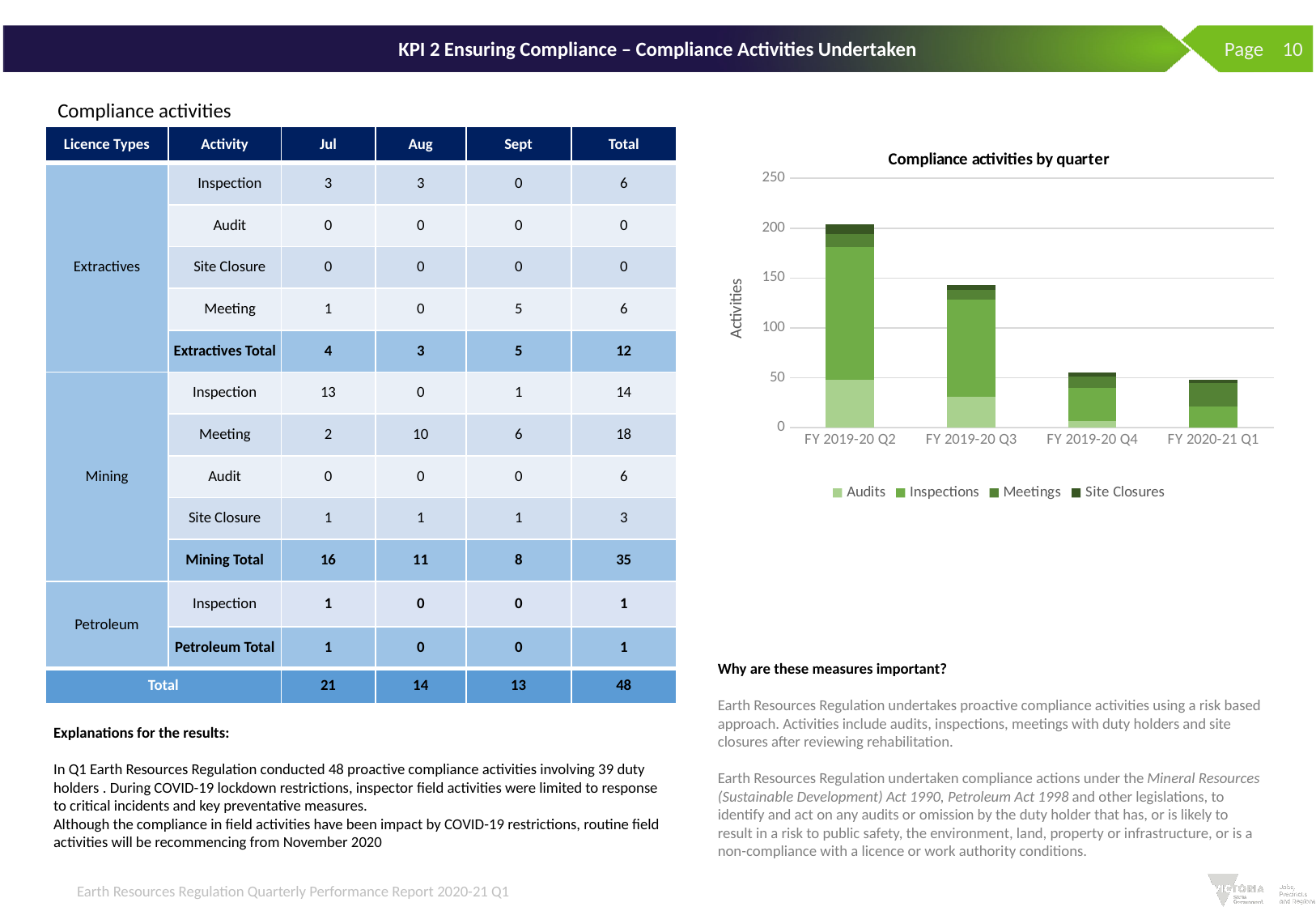
Is the total for FY 2019-20 Q2 greater or less than 150? greater Do the total compliance activities rise or fall across the quarters from FY 2019-20 Q2 to FY 2020-21 Q1? fall What is the title of the chart? Compliance activities by quarter What is the label on the vertical axis of the chart? Activities Is the total for FY 2020-21 Q1 greater or less than 100? less Is the total for FY 2019-20 Q4 greater or less than 100? less How many series does the chart legend list? 4 What kind of chart is shown on the slide? Stacked bar chart Which quarter has a larger total of compliance activities, FY 2019-20 Q2 or FY 2019-20 Q3? FY 2019-20 Q2 How many quarters are shown on the x axis of the chart? 4 Which quarter has the highest total number of compliance activities in the chart? FY 2019-20 Q2